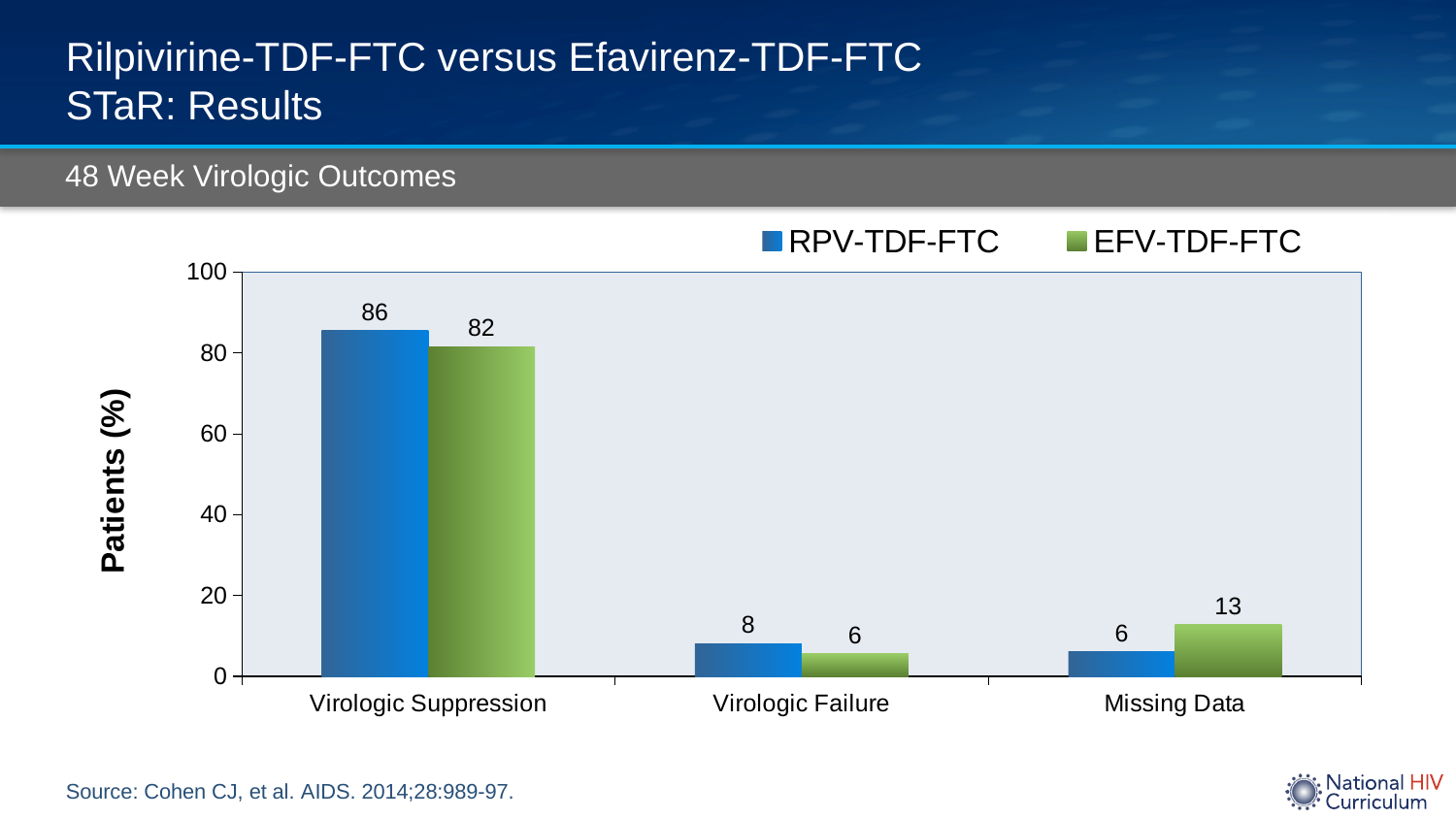
What is the value for RPV-TDF-FTC in the Virologic Suppression category? 86 What kind of chart is shown on the slide? Bar chart What is the value for EFV-TDF-FTC in the Missing Data category? 13 Which series has the larger value in the Virologic Failure category, RPV-TDF-FTC or EFV-TDF-FTC? RPV-TDF-FTC How many categories are shown on the x axis? 3 Which category has the lowest value for EFV-TDF-FTC? Virologic Failure How many series does the legend list? 2 What is the difference between EFV-TDF-FTC and RPV-TDF-FTC in the Missing Data category? 7 What is the value for EFV-TDF-FTC in the Virologic Failure category? 6 Is the value for EFV-TDF-FTC in the Virologic Suppression category greater or less than 80? greater Which category has the highest value for RPV-TDF-FTC? Virologic Suppression What is the difference between RPV-TDF-FTC and EFV-TDF-FTC in the Virologic Suppression category? 4